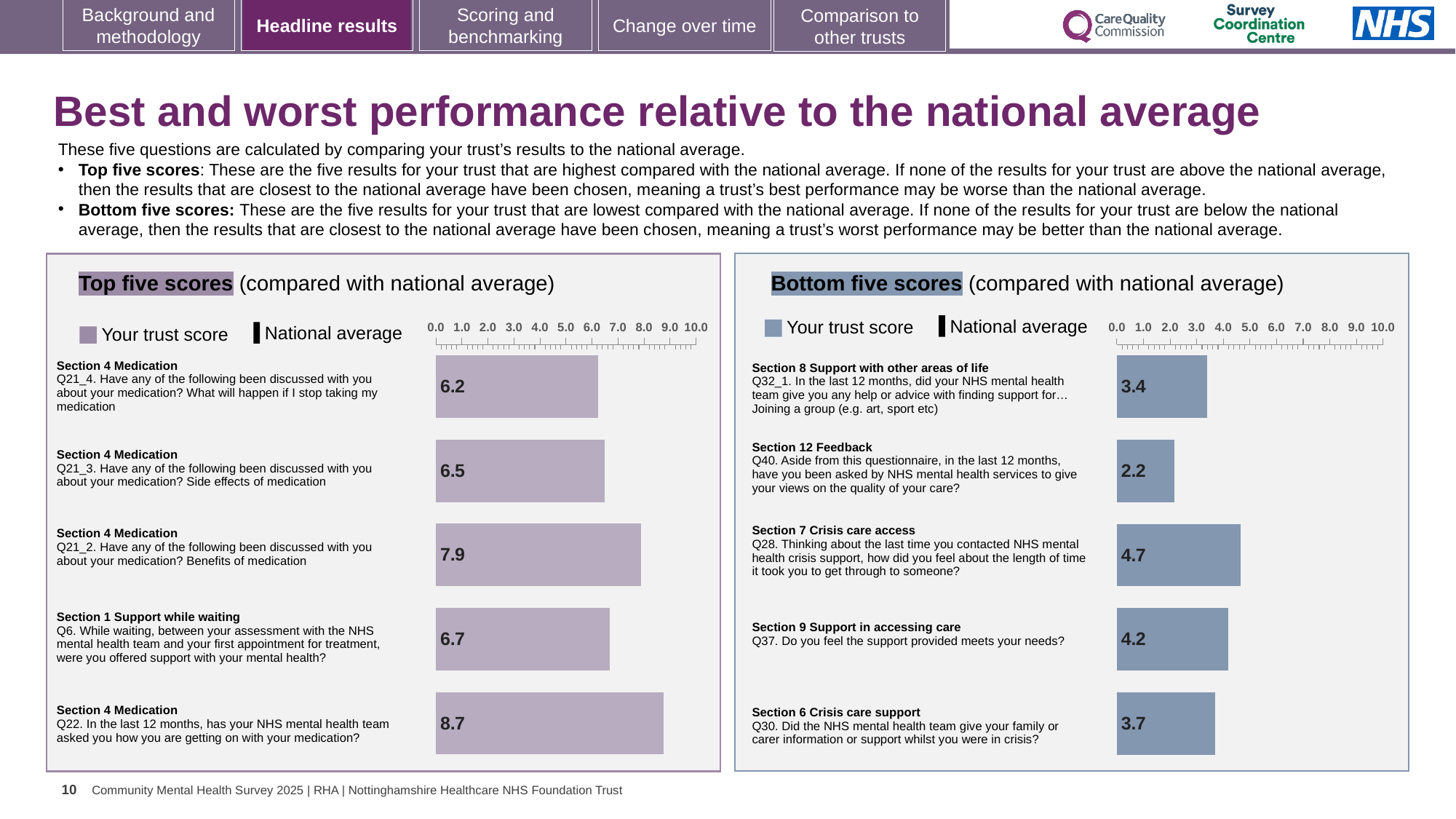
In the Top five scores chart, which question has the lowest trust score? Q21_4 How many bars are plotted in the Bottom five scores chart? 5 In the Top five scores chart, what is the trust score for Q6 (were you offered support with your mental health while waiting)? 6.7 In the Top five scores chart, which question has the highest trust score? Q22 In the Bottom five scores chart, which question has the highest trust score? Q28 In the Bottom five scores chart, what is the trust score for Q28 (how did you feel about the length of time it took to get through to someone)? 4.7 In the Bottom five scores chart, which has the larger trust score, Q37 or Q30? Q37 In the Bottom five scores chart, which question has the lowest trust score? Q40 What type of chart is used for the Top five scores? Bar chart In the Top five scores chart, what is the difference between the trust scores for Q22 and Q21_4? 2.5 In the Top five scores chart, what is the trust score for Q22 (has your NHS mental health team asked you how you are getting on with your medication)? 8.7 In the Bottom five scores chart, what is the trust score for Q40 (asked by NHS mental health services to give your views on the quality of your care)? 2.2